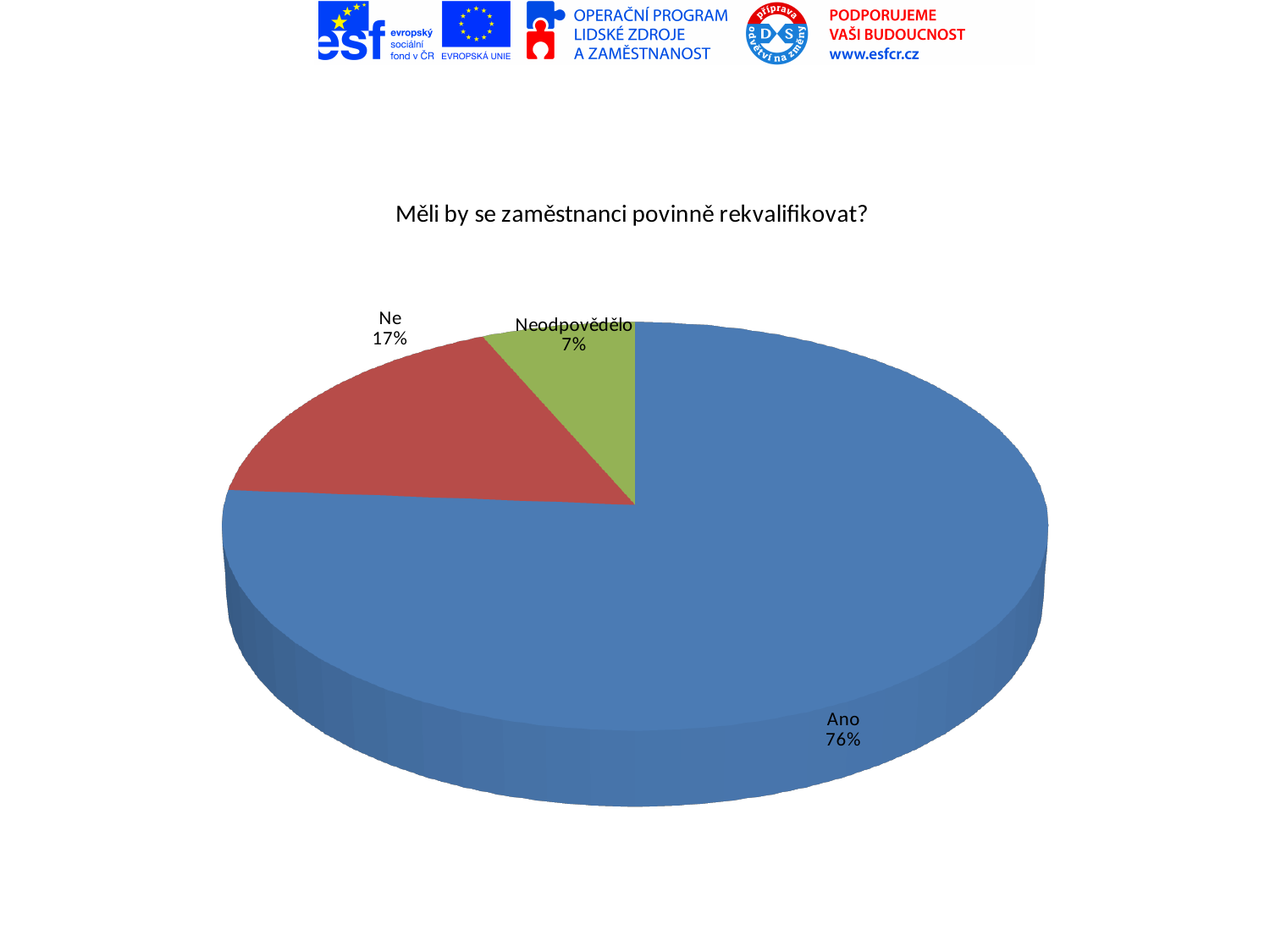
Which is larger, the share for "Ne" or the share for "Neodpovědělo"? Ne What share of the pie is labelled "Neodpovědělo"? 7% What colour is the "Ano" slice? blue What is the title of the chart? Měli by se zaměstnanci povinně rekvalifikovat? Which category has the smallest share of the pie? Neodpovědělo What percentage of respondents answered "Ne"? 17% What percentage of respondents answered "Ano"? 76% What is the difference in percentage points between "Ne" and "Neodpovědělo"? 10 How many slices does the pie chart have? 3 What kind of chart is shown on the slide? pie chart Which category has the largest share of the pie? Ano What is the difference in percentage points between "Ano" and "Ne"? 59